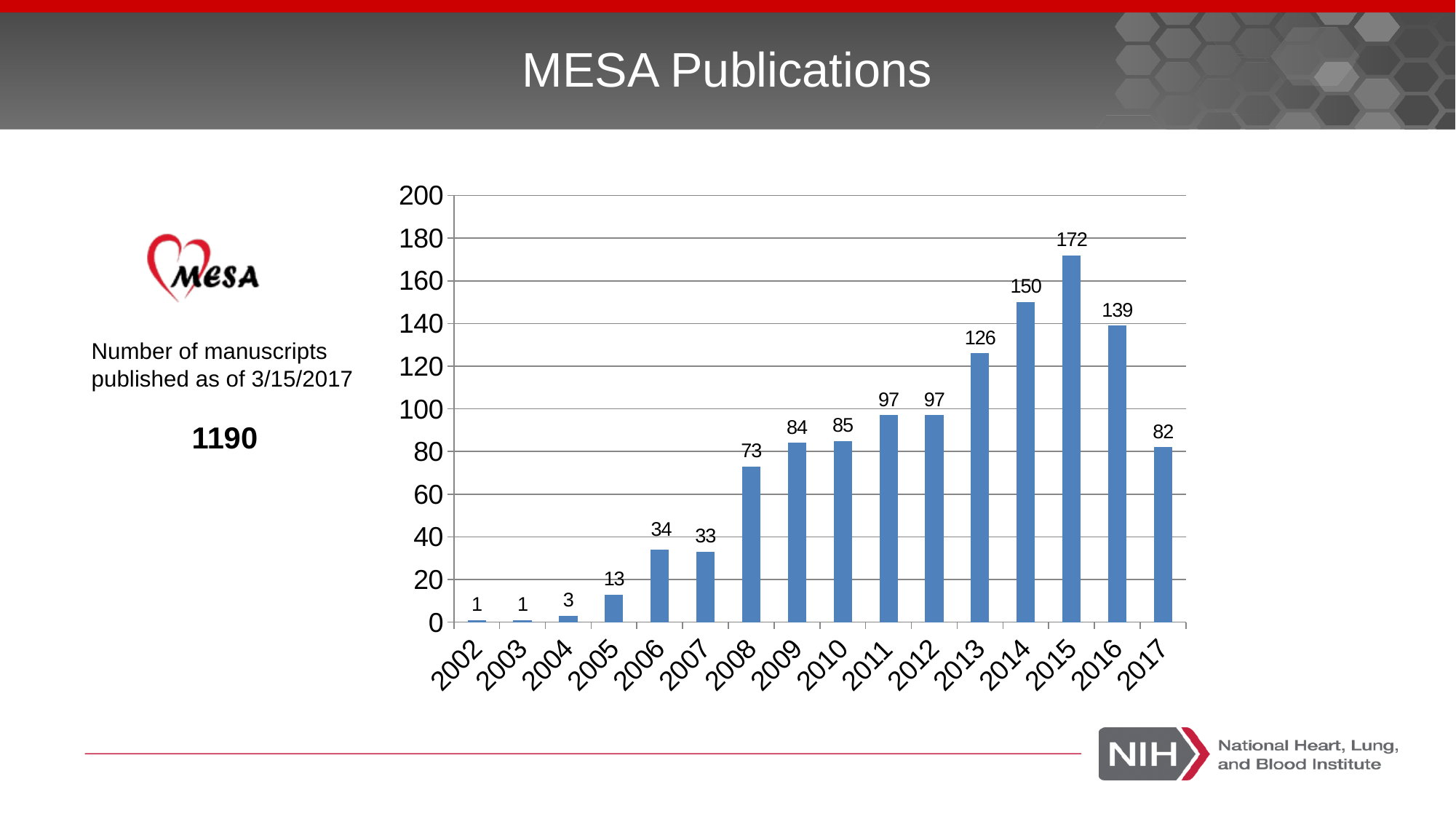
What is the title of the slide containing the chart? MESA Publications Which is larger, the value for 2006 or the value for 2007? 2006 Which year has the highest value? 2015 What is the difference between the values for 2015 and 2016? 33 What is the difference between the values for 2014 and 2013? 24 What is the value for 2008? 73 What kind of chart is shown on the slide? bar chart How many years are shown on the x axis? 16 What is the value for 2013? 126 What is the value for 2015? 172 Which is larger, the value for 2016 or the value for 2017? 2016 Do the values generally rise or fall from 2002 to 2015? rise